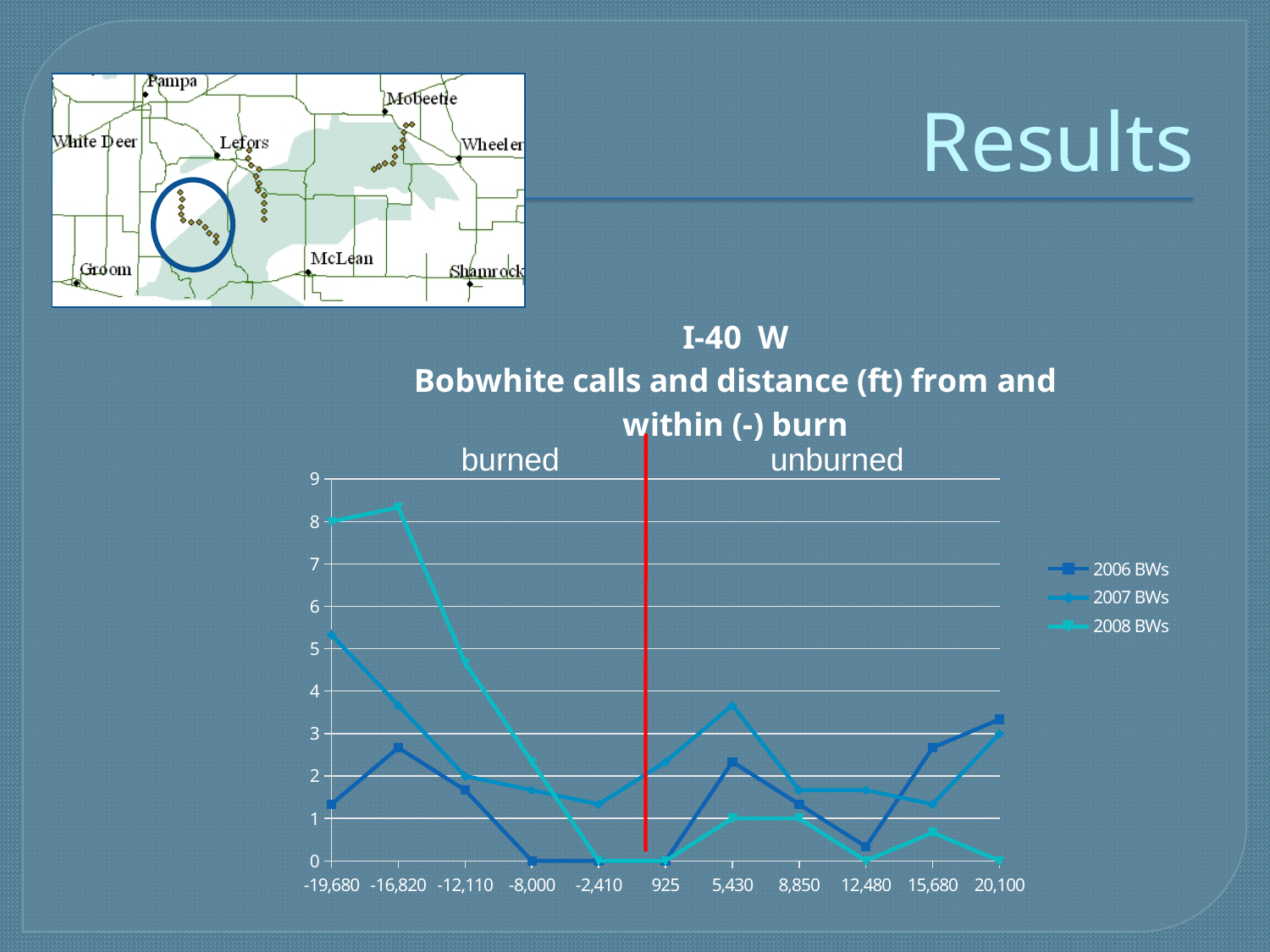
At 5,430, which series has the larger value, 2006 BWs or 2007 BWs? 2007 BWs What are the three series named in the legend? 2006 BWs, 2007 BWs, 2008 BWs Which series has the lowest value at 12,480? 2008 BWs How many series does the legend list? 3 Is the value for 2007 BWs at -19,680 greater or less than 4? greater Do the values for 2008 BWs rise or fall from -16,820 to -2,410? fall What is the value for 2006 BWs at -8,000? 0 What kind of chart is shown on the slide? line chart How many distance categories are shown on the x axis? 11 Is the value for 2006 BWs at 20,100 greater or less than 2? greater Is the value for 2008 BWs at -16,820 greater or less than 7? greater Which series has the highest value at -19,680? 2008 BWs